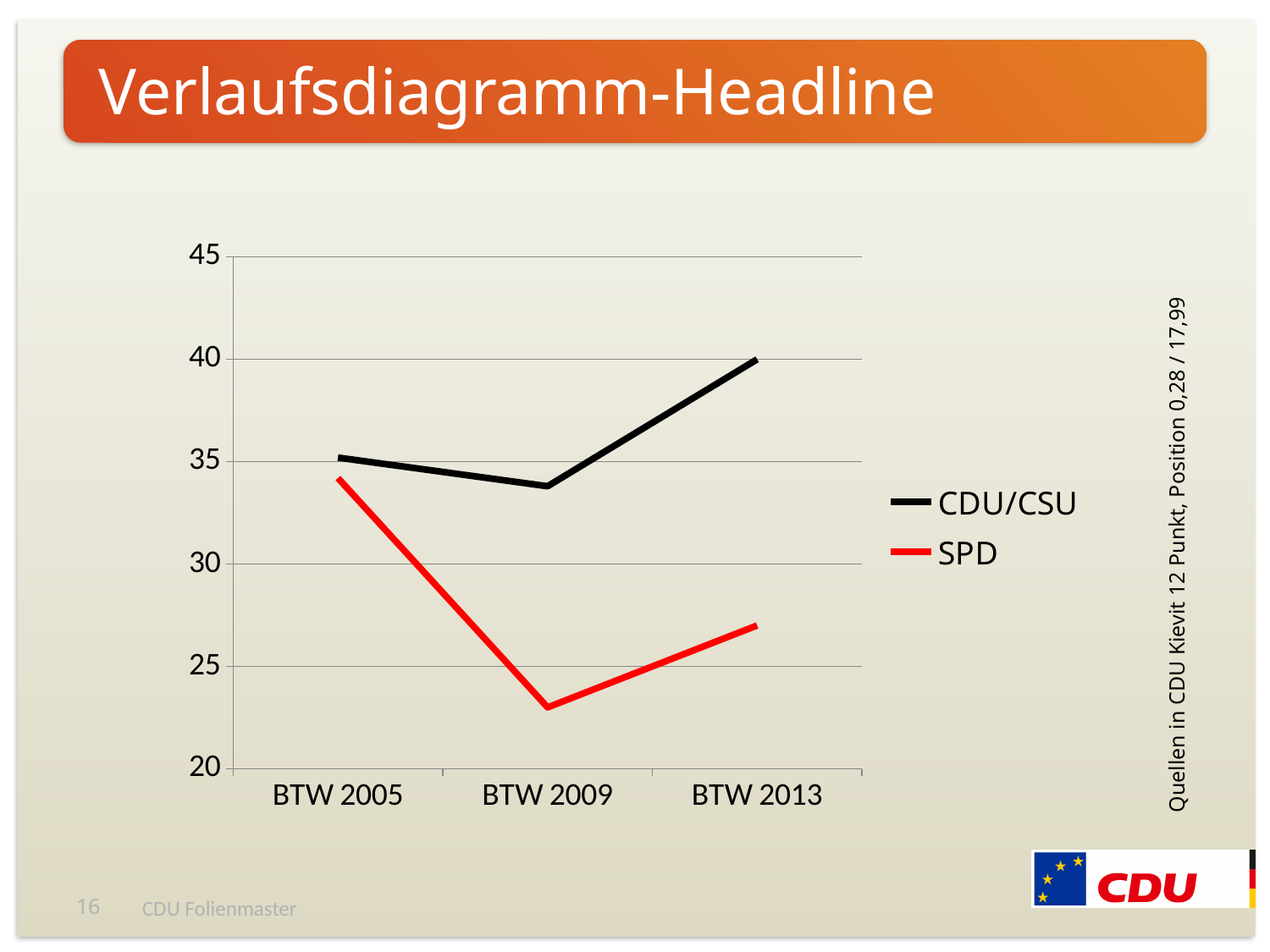
Which series has the larger value at BTW 2013, CDU/CSU or SPD? CDU/CSU Is the value for CDU/CSU at BTW 2009 greater or less than 30? greater Which series is shown in red in the legend? SPD At which election does the CDU/CSU line reach its highest value? BTW 2013 Is the value for SPD at BTW 2005 greater or less than 30? greater Is the value for SPD at BTW 2009 greater or less than 25? less What kind of chart is shown on the slide? line chart What is the title of the slide containing the chart? Verlaufsdiagramm-Headline How many points along the x axis does the chart have? 3 At which election does the SPD line reach its lowest value? BTW 2009 How many series does the legend list? 2